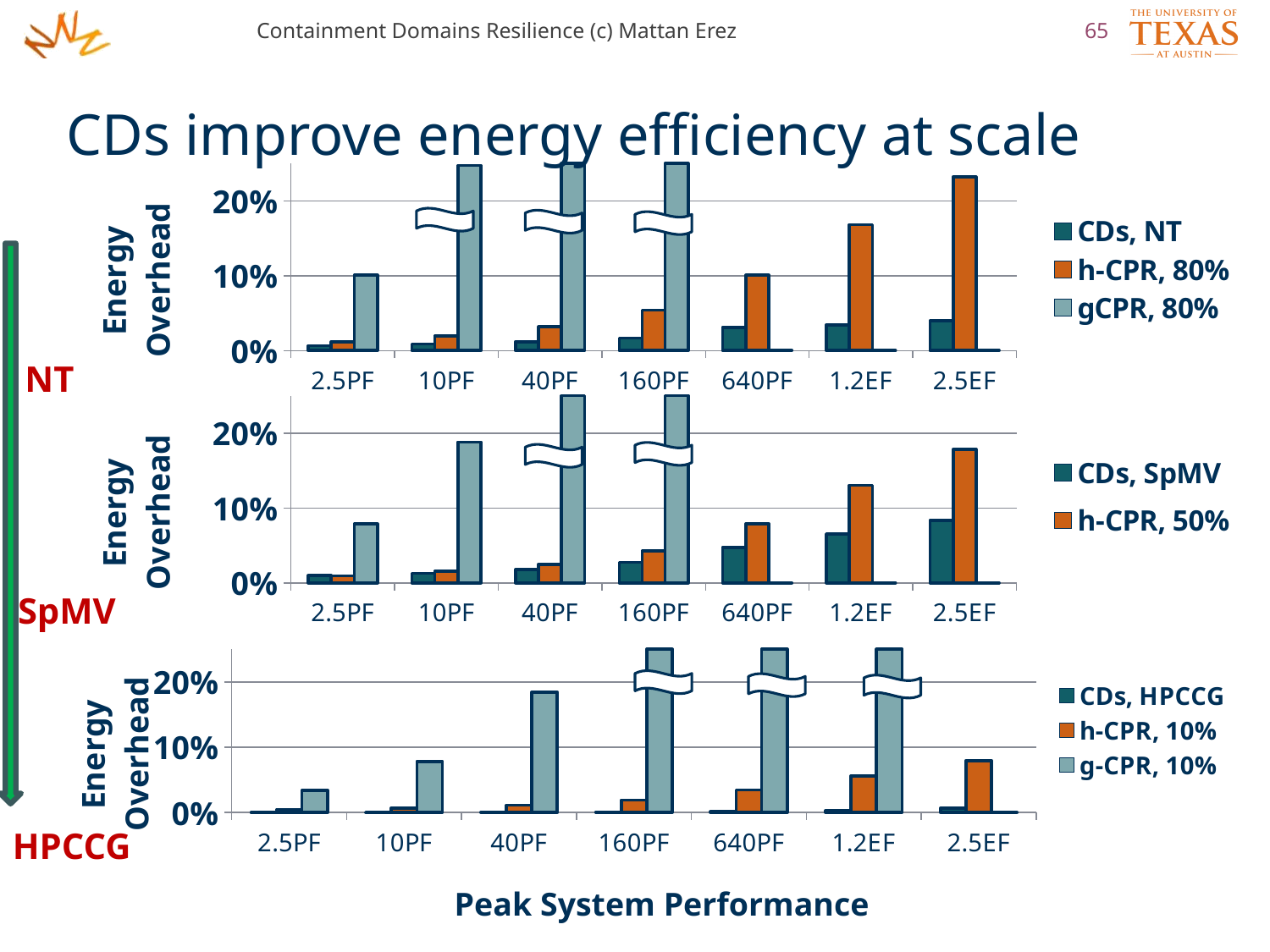
In the top chart (NT), at 640PF, which is larger: CDs, NT or h-CPR, 80%? h-CPR, 80% In the top chart (NT), is the value for h-CPR, 80% at 2.5EF greater or less than 20%? greater In the top chart (NT), is the value for h-CPR, 80% at 1.2EF greater or less than 20%? less In the middle chart (SpMV), is the value for h-CPR, 50% at 2.5EF greater or less than 20%? less What is the x-axis title shared by the charts on the slide? Peak System Performance In the top chart (NT), do the h-CPR, 80% bars rise or fall as peak system performance increases along the x axis? rise How many series does the legend of the top chart (NT) list? 3 How many series does the legend of the middle chart (SpMV) list? 2 How many peak system performance categories are shown on the x axis of the bottom chart (HPCCG)? 7 In the bottom chart (HPCCG), which category has the highest h-CPR, 10% value? 2.5EF What kind of chart is the top chart (NT)? bar chart